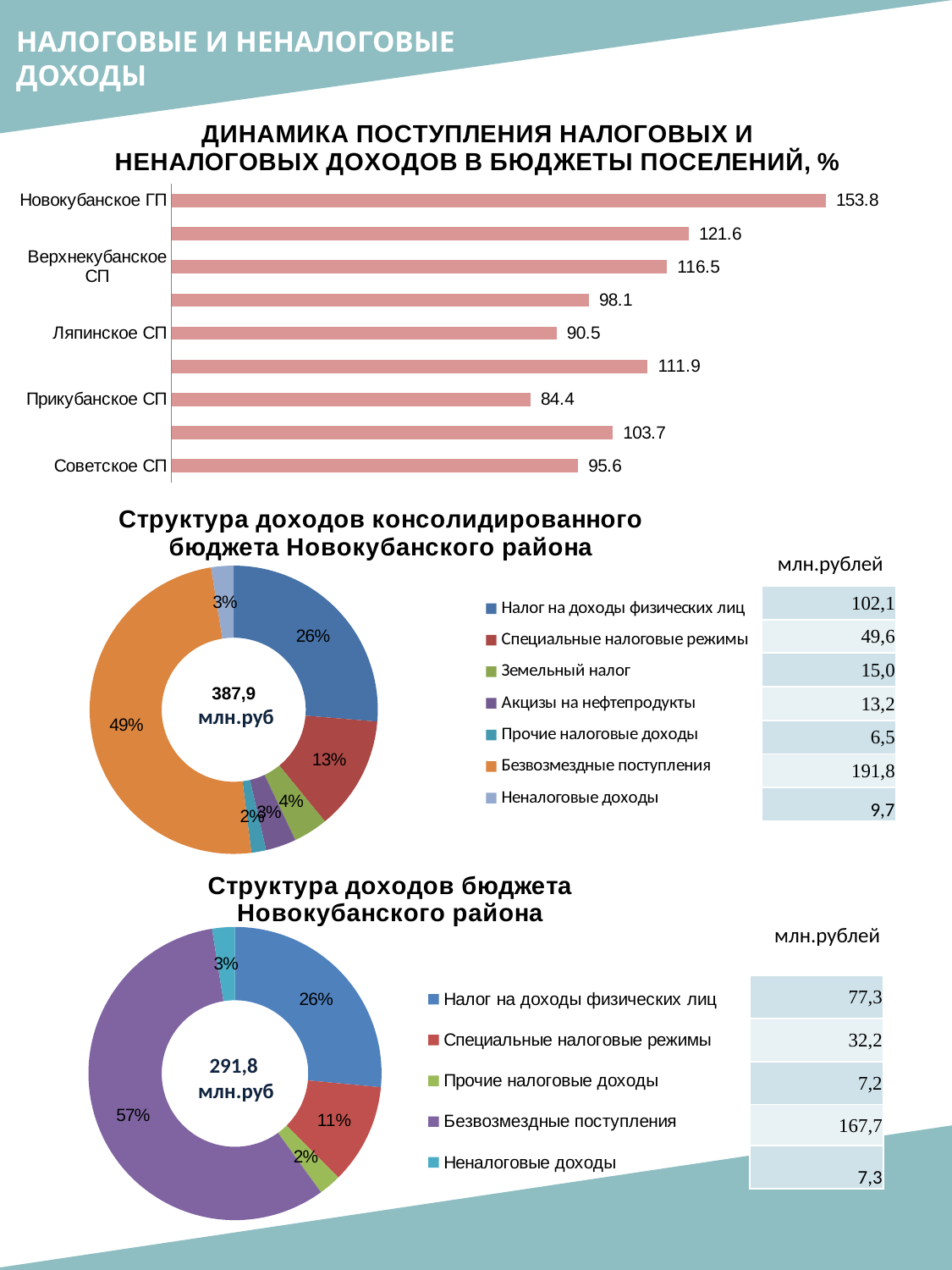
In the chart 'Структура доходов консолидированного бюджета Новокубанского района', what share does Безвозмездные поступления have? 49% What kind of chart is 'Динамика поступления налоговых и неналоговых доходов в бюджеты поселений, %'? Bar chart In the bar chart 'Динамика поступления налоговых и неналоговых доходов в бюджеты поселений, %', which labelled settlement has the highest value? Новокубанское ГП In the bar chart 'Динамика поступления налоговых и неналоговых доходов в бюджеты поселений, %', which is larger: the value for Верхнекубанское СП or for Советское СП? Верхнекубанское СП How many bars are plotted in the bar chart 'Динамика поступления налоговых и неналоговых доходов в бюджеты поселений, %'? 9 In the bar chart 'Динамика поступления налоговых и неналоговых доходов в бюджеты поселений, %', which labelled settlement has the lowest value? Прикубанское СП How many series does the legend list in the chart 'Структура доходов консолидированного бюджета Новокубанского района'? 7 In the chart 'Структура доходов бюджета Новокубанского района', what is the value in млн.рублей for Безвозмездные поступления? 167,7 In the bar chart 'Динамика поступления налоговых и неналоговых доходов в бюджеты поселений, %', what is the value for Новокубанское ГП? 153.8 In the chart 'Структура доходов бюджета Новокубанского района', what total is shown in the centre of the doughnut? 291,8 млн.руб In the bar chart 'Динамика поступления налоговых и неналоговых доходов в бюджеты поселений, %', what is the difference between the values for Новокубанское ГП and Ляпинское СП? 63.3 In the bar chart 'Динамика поступления налоговых и неналоговых доходов в бюджеты поселений, %', what is the value for Советское СП? 95.6